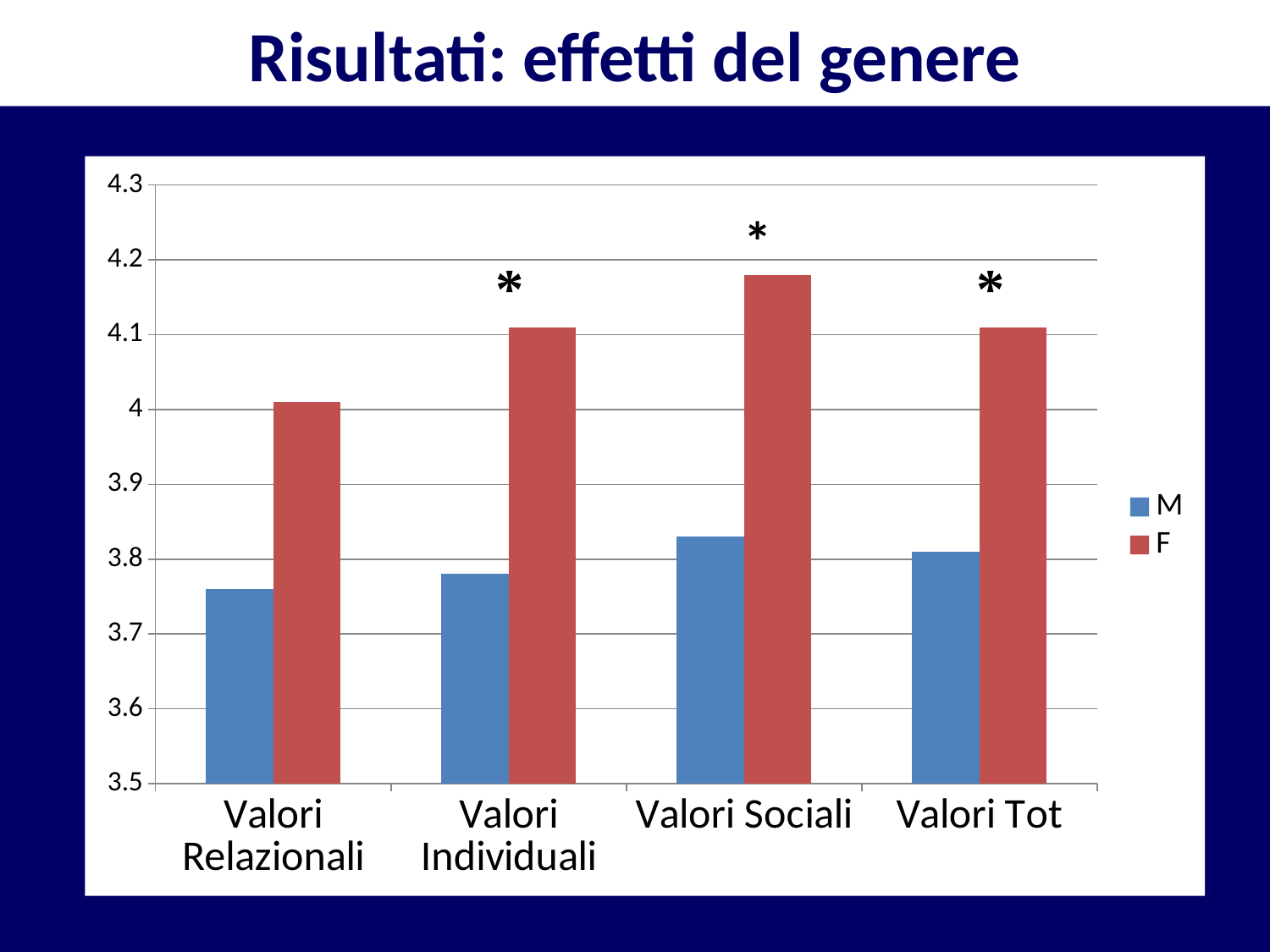
Which category has the lowest F value? Valori Relazionali For Valori Relazionali, which series has the larger value, M or F? F What are the two series listed in the legend? M and F For Valori Sociali, which series has the larger value, M or F? F What is the title of the slide? Risultati: effetti del genere What kind of chart is shown on the slide? bar chart Is the M value for Valori Sociali greater or less than 3.9? less Is the F value for Valori Individuali greater or less than 4? greater How many categories are shown on the x axis? 4 Which category has the highest F value? Valori Sociali How many series does the legend list? 2 Is the F value for Valori Sociali greater or less than 4.1? greater